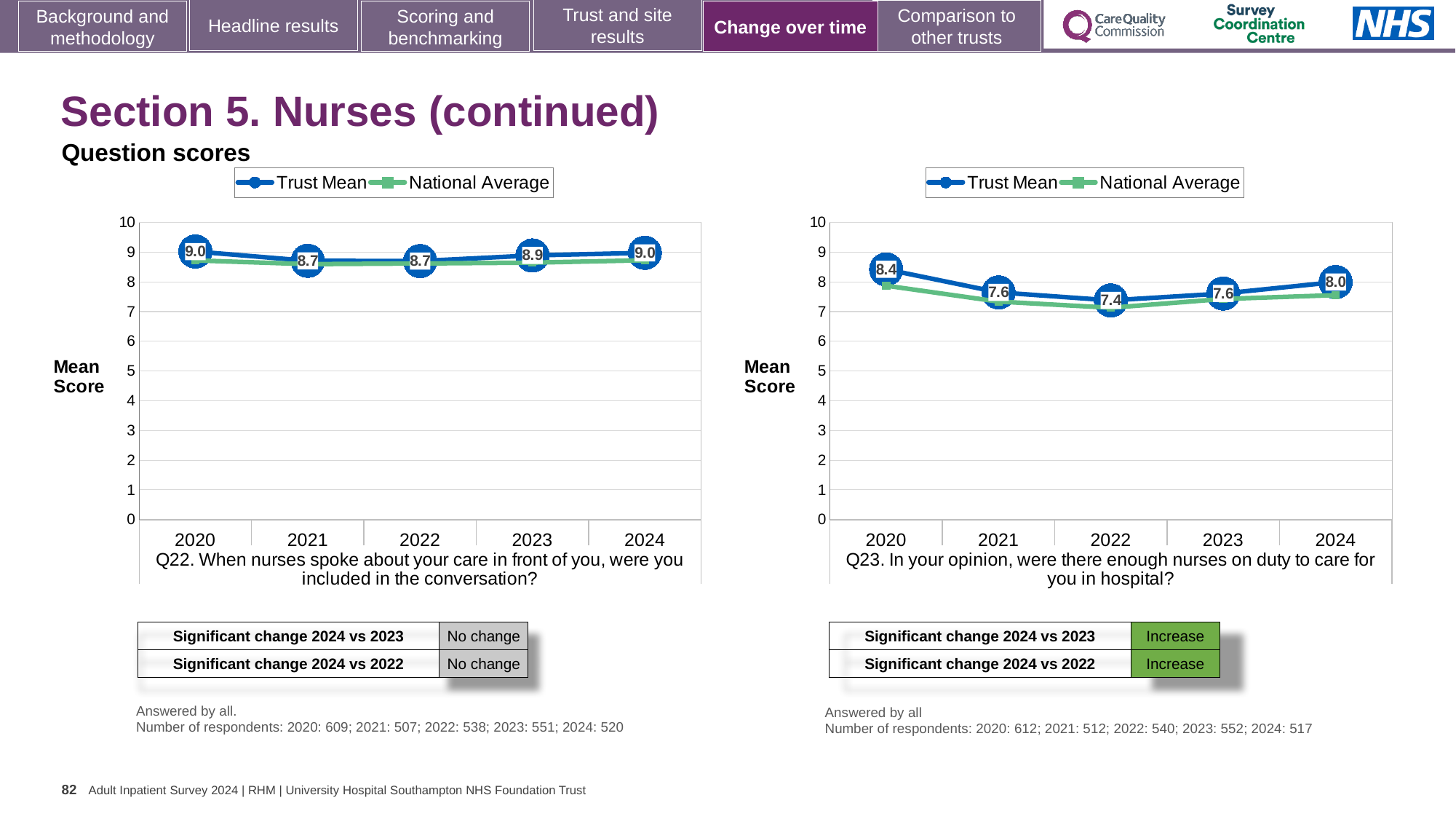
On the Q23 chart (right), what is the difference between the Trust Mean scores for 2020 and 2022? 1.0 On the Q23 chart (right), what is the Trust Mean score for 2020? 8.4 How many years are shown on the x axis of the Q22 chart (left)? 5 On the Q23 chart (right), does the Trust Mean score rise or fall from 2022 to 2024? Rise What kind of chart is the Q22 chart (left)? Line chart On the Q23 chart (right), which year has the highest Trust Mean score? 2020 On the Q22 chart (left), is the National Average value for 2020 greater or less than 8? greater On the Q23 chart (right), is the Trust Mean score higher in 2020 or in 2024? 2020 How many series does the legend of the Q23 chart (right) list? 2 On the Q22 chart (left), what is the Trust Mean score for 2021? 8.7 On the Q22 chart (left), what is the Trust Mean score for 2024? 9.0 On the Q23 chart (right), which year has the lowest Trust Mean score? 2022